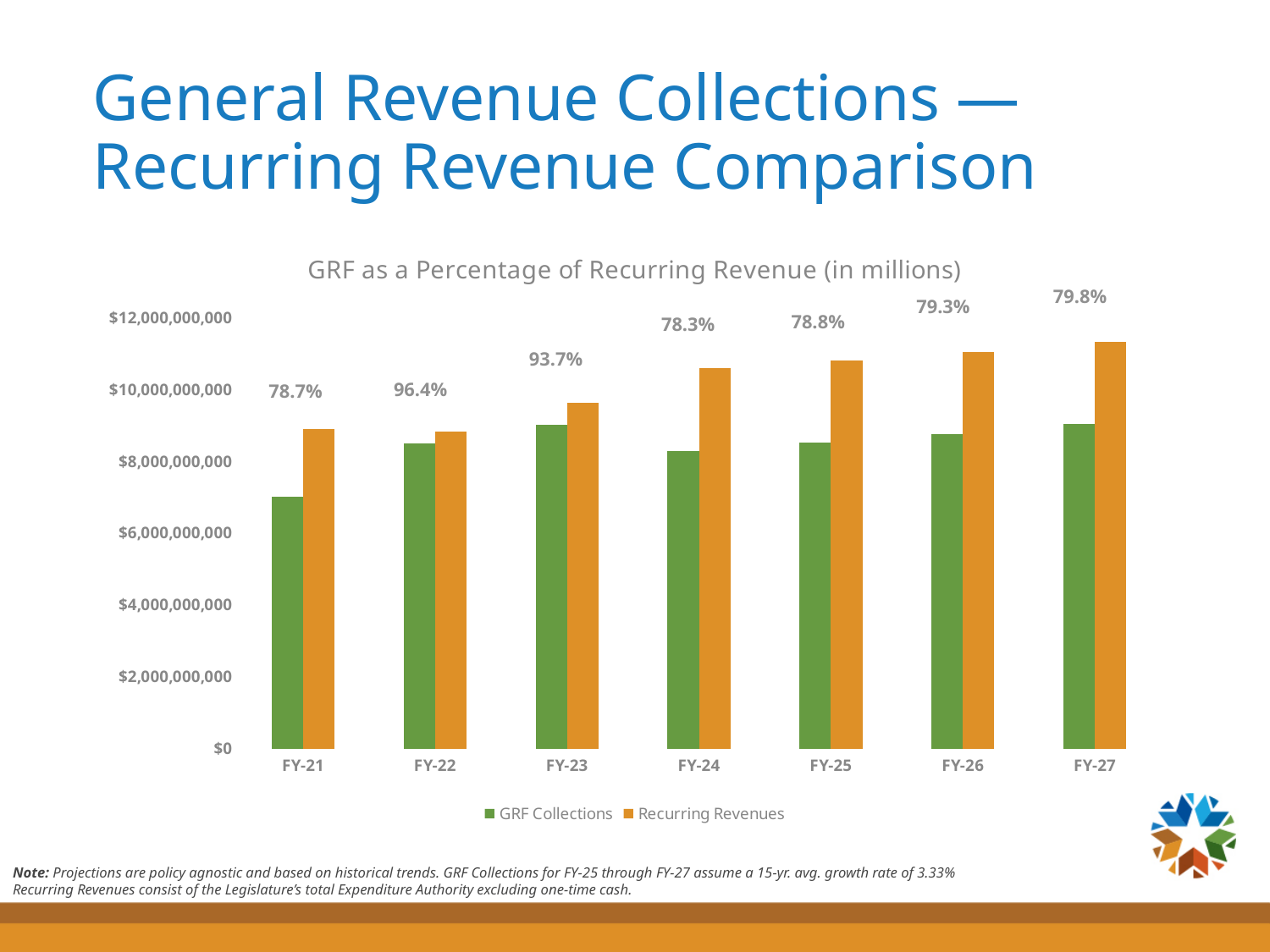
Which fiscal year has the highest percentage label? FY-22 Is the GRF Collections value for FY-21 greater or less than $8,000,000,000? less What percentage label is shown above the FY-24 bars? 78.3% In FY-21, which is larger: GRF Collections or Recurring Revenues? Recurring Revenues How many series does the legend list? 2 What percentage label is shown above the FY-27 bars? 79.8% Is the Recurring Revenues value for FY-27 greater or less than $10,000,000,000? greater How many fiscal years are shown on the x axis? 7 What kind of chart is shown on the slide? Bar chart Which fiscal year has the lowest percentage label? FY-24 What is the difference in percentage points between the FY-22 label and the FY-21 label? 17.7 percentage points What percentage label is shown above the FY-22 bars? 96.4%